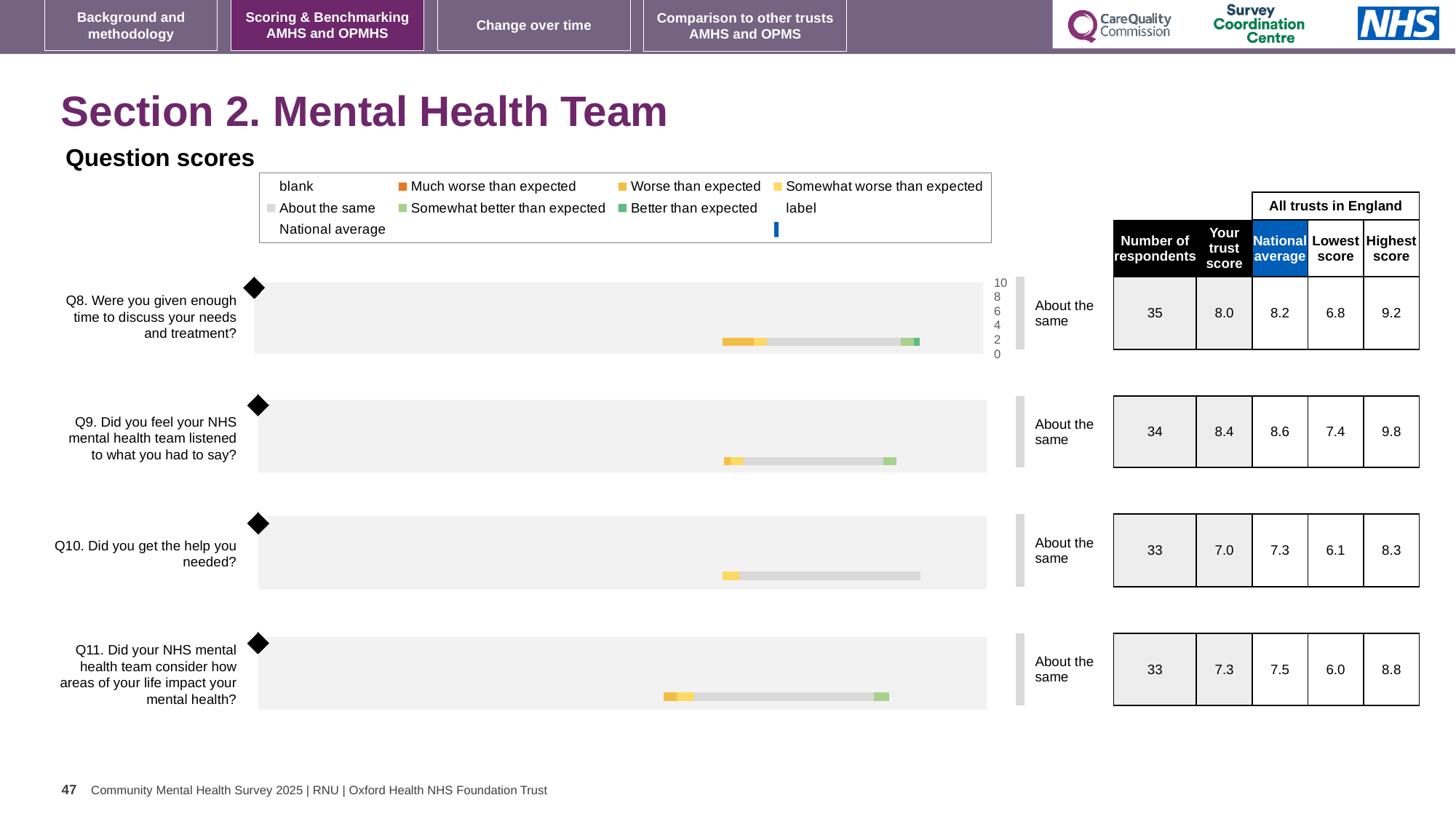
In the table next to the Q8 chart, what is the trust score for Q8? 8.0 Which question (Q8 to Q11) has the highest trust score in the table? Q9 How many respondents answered Q9, according to the table next to the Q9 chart? 34 What type of chart is used to show the question scores for Q8 to Q11? bar chart For Q8, which is larger: the trust score or the national average? national average How many questions (Q8 to Q11) have a score chart on the slide? 4 In the legend, what colour represents 'Much worse than expected'? orange For Q10, what is the difference between the highest score and the lowest score among all trusts in England? 2.2 Which question (Q8 to Q11) has the lowest trust score in the table? Q10 In the table next to the Q9 chart, what is the national average for Q9? 8.6 In the table next to the Q10 chart, what is the lowest score among all trusts in England for Q10? 6.1 In the table next to the Q11 chart, what is the highest score among all trusts in England for Q11? 8.8